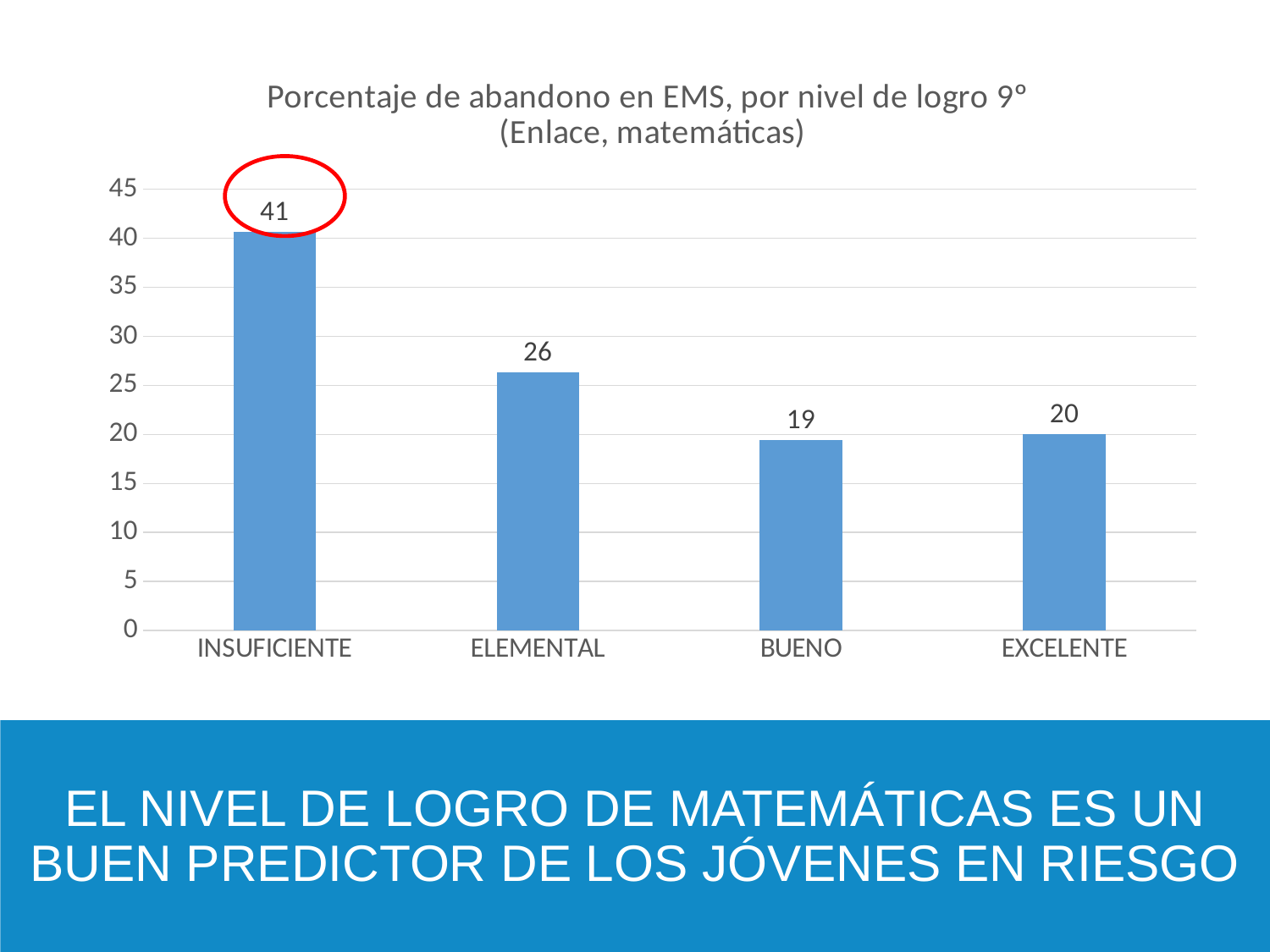
Which is larger, the value for ELEMENTAL or the value for EXCELENTE? ELEMENTAL Which category has the lowest value? BUENO What is the value for BUENO? 19 What is the difference between the values for INSUFICIENTE and ELEMENTAL? 15 What kind of chart is shown on the slide? bar chart What is the value for INSUFICIENTE? 41 How many categories are shown on the x axis? 4 Is the value for INSUFICIENTE greater or less than 35? greater What is the value for ELEMENTAL? 26 What is the title of the chart? Porcentaje de abandono en EMS, por nivel de logro 9° (Enlace, matemáticas) What is the value for EXCELENTE? 20 Which category has the highest value? INSUFICIENTE